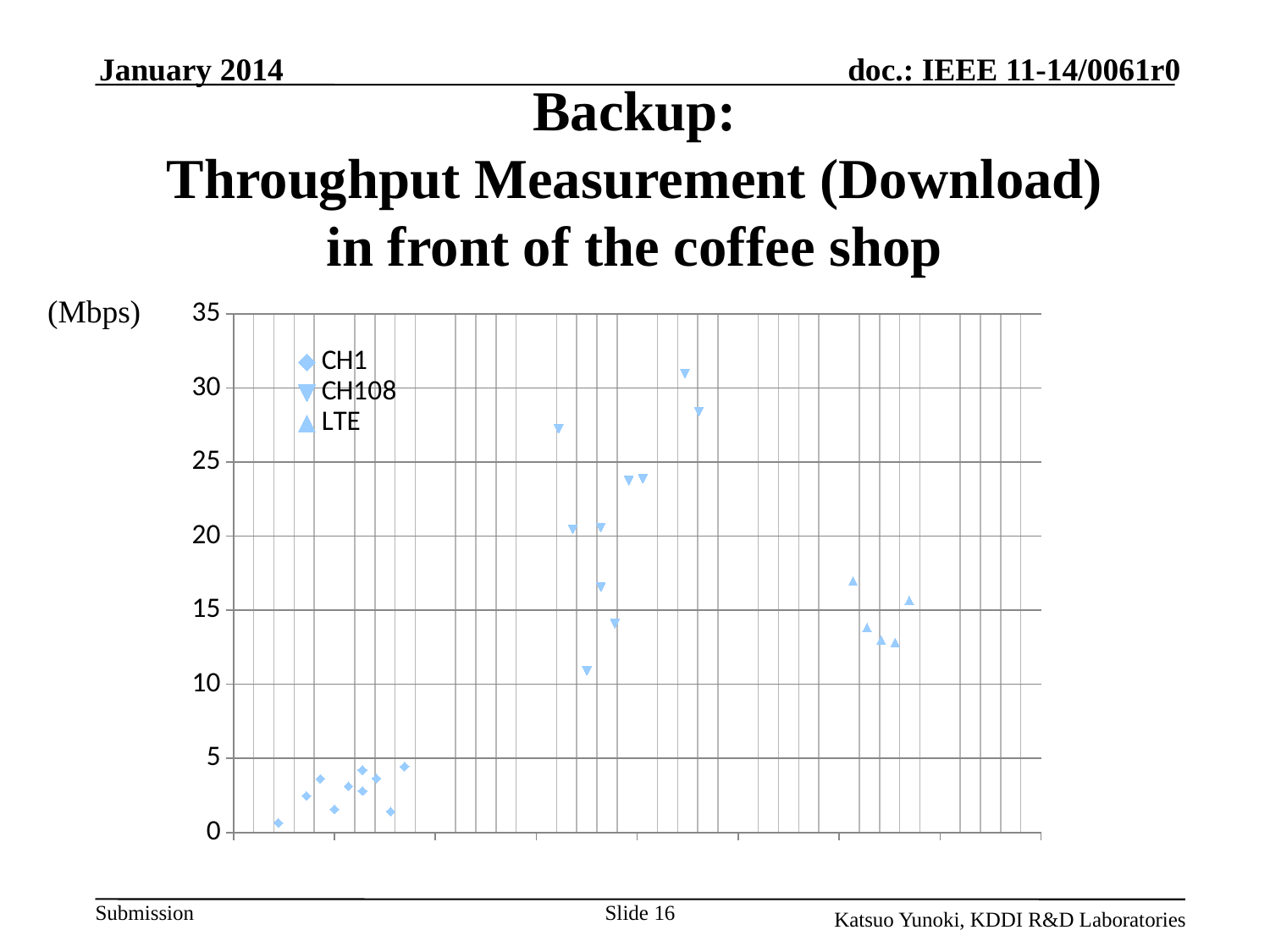
What kind of chart is shown on the slide? scatter chart What unit is shown for the vertical axis? Mbps Is the highest LTE value greater or less than 20? less Is the highest CH108 value greater or less than 30? greater How many LTE data points are plotted? 5 Are all the CH1 values greater or less than 5? less Which series reaches the highest throughput value on the chart? CH108 Which series has the lowest throughput values on the chart? CH1 How many series does the legend list? 3 What are the series names listed in the legend? CH1, CH108, LTE Which series has higher throughput values overall, CH1 or LTE? LTE